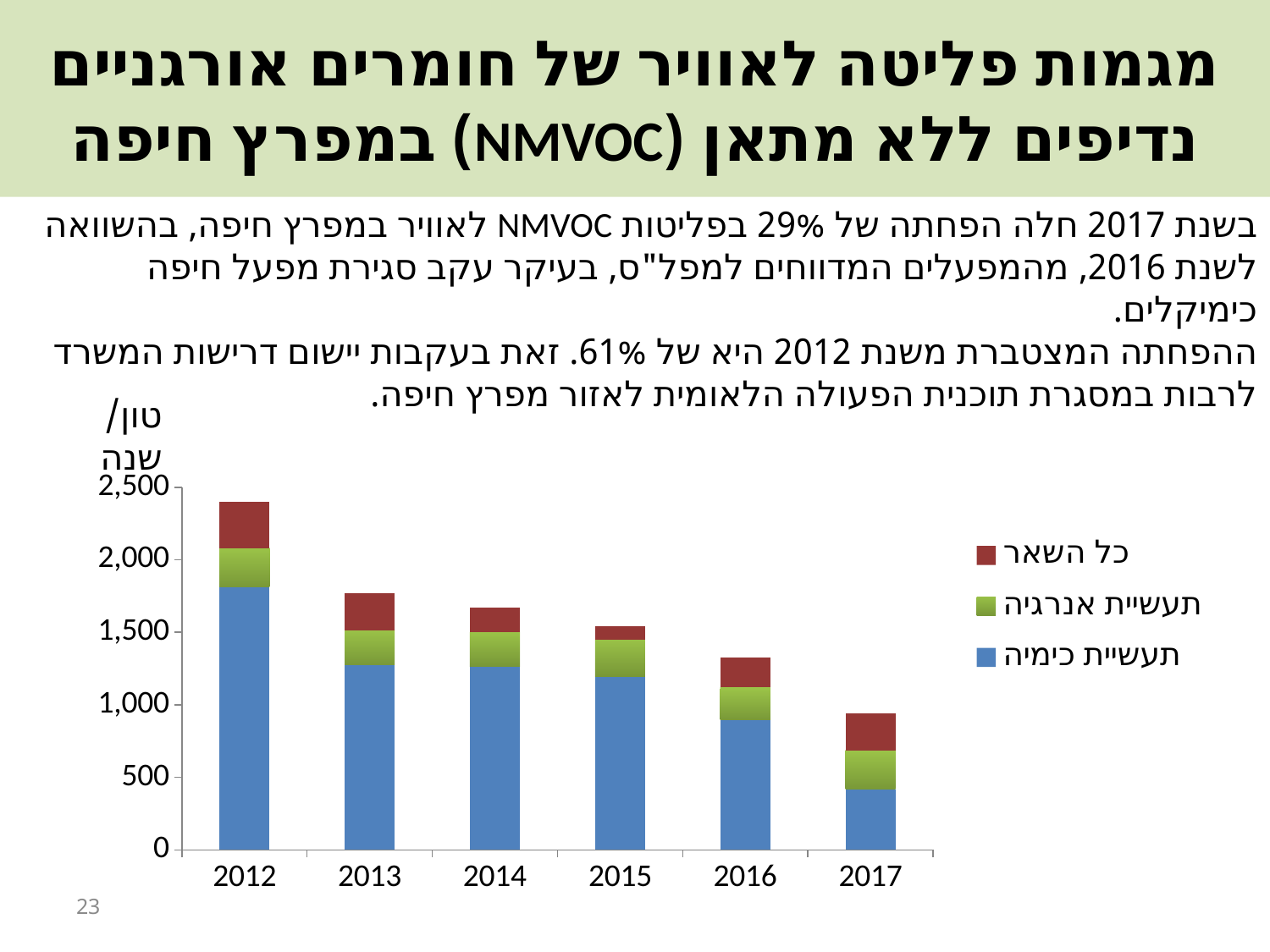
Is the value of תעשיית כימיה for 2017 greater or less than 500? less Which year has the highest total bar in the chart? 2012 Which year has the lowest total bar in the chart? 2017 How many series does the chart legend list? 3 Is the total value for 2017 greater or less than 1,000? less Is the value of תעשיית כימיה for 2012 greater or less than 1,500? greater What kind of chart is shown on the slide? Stacked bar chart What is the label on the y axis of the chart? טון/שנה How many years are shown on the x axis of the chart? 6 Which is larger, the total bar for 2013 or the total bar for 2016? 2013 Do the total bar heights rise or fall from 2012 to 2017? Fall